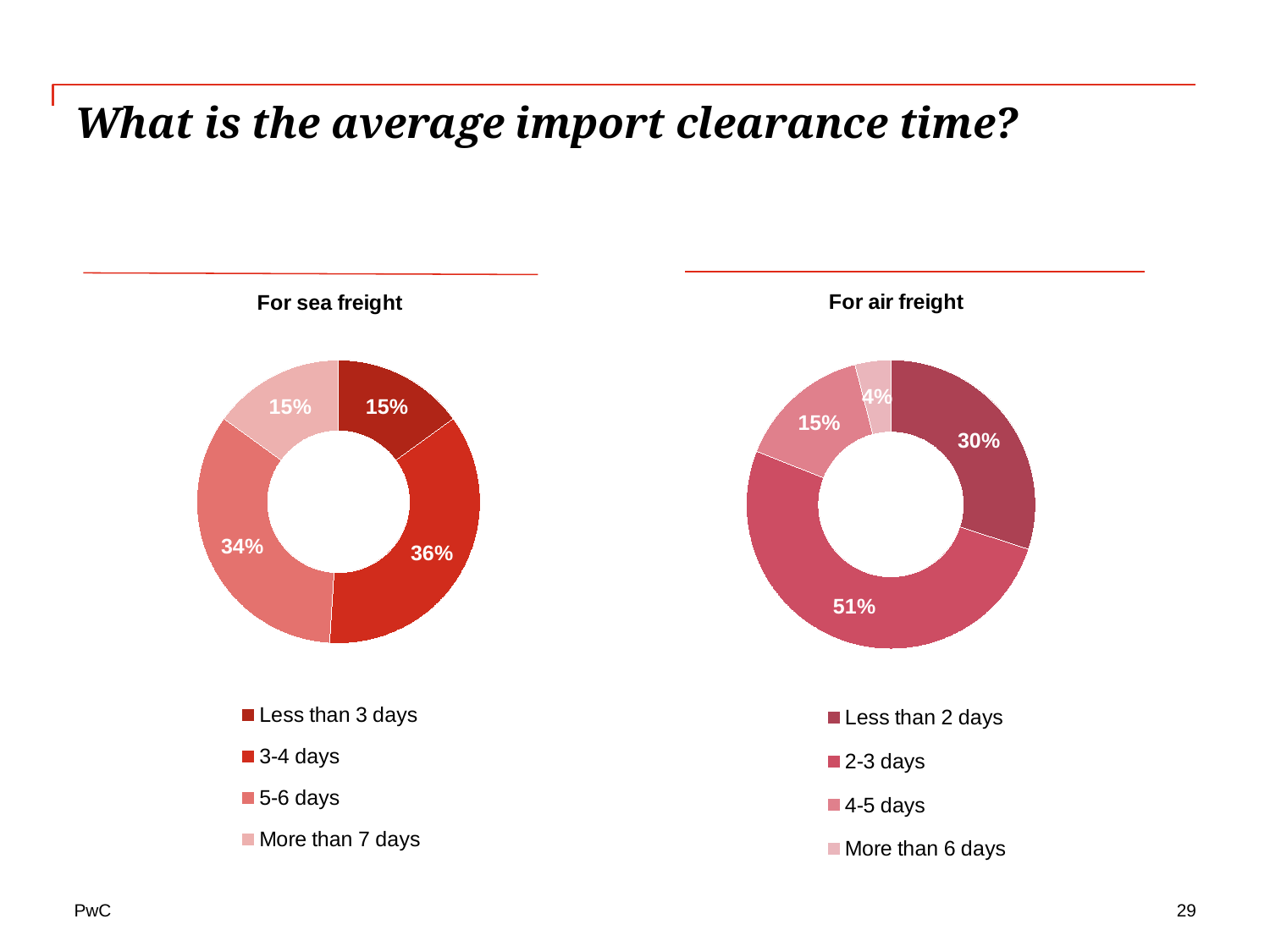
In the 'For sea freight' chart, what share of respondents reported 5-6 days? 34% How many categories does the legend of the 'For sea freight' chart list? 4 In the 'For air freight' chart, which category has the largest share? 2-3 days In the 'For air freight' chart, what is the difference between the shares for 2-3 days and less than 2 days? 21% In the 'For sea freight' chart, what share of respondents reported 3-4 days? 36% What type of chart is used for 'For air freight'? Doughnut chart In the 'For sea freight' chart, which category has the largest share? 3-4 days In the 'For air freight' chart, what share of respondents reported more than 6 days? 4% In the 'For air freight' chart, which category has the smallest share? More than 6 days In the 'For sea freight' chart, which is larger: the share for 3-4 days or the share for 5-6 days? 3-4 days What is the title of the chart on the left side of the slide? For sea freight In the 'For air freight' chart, what share of respondents reported 2-3 days? 51%